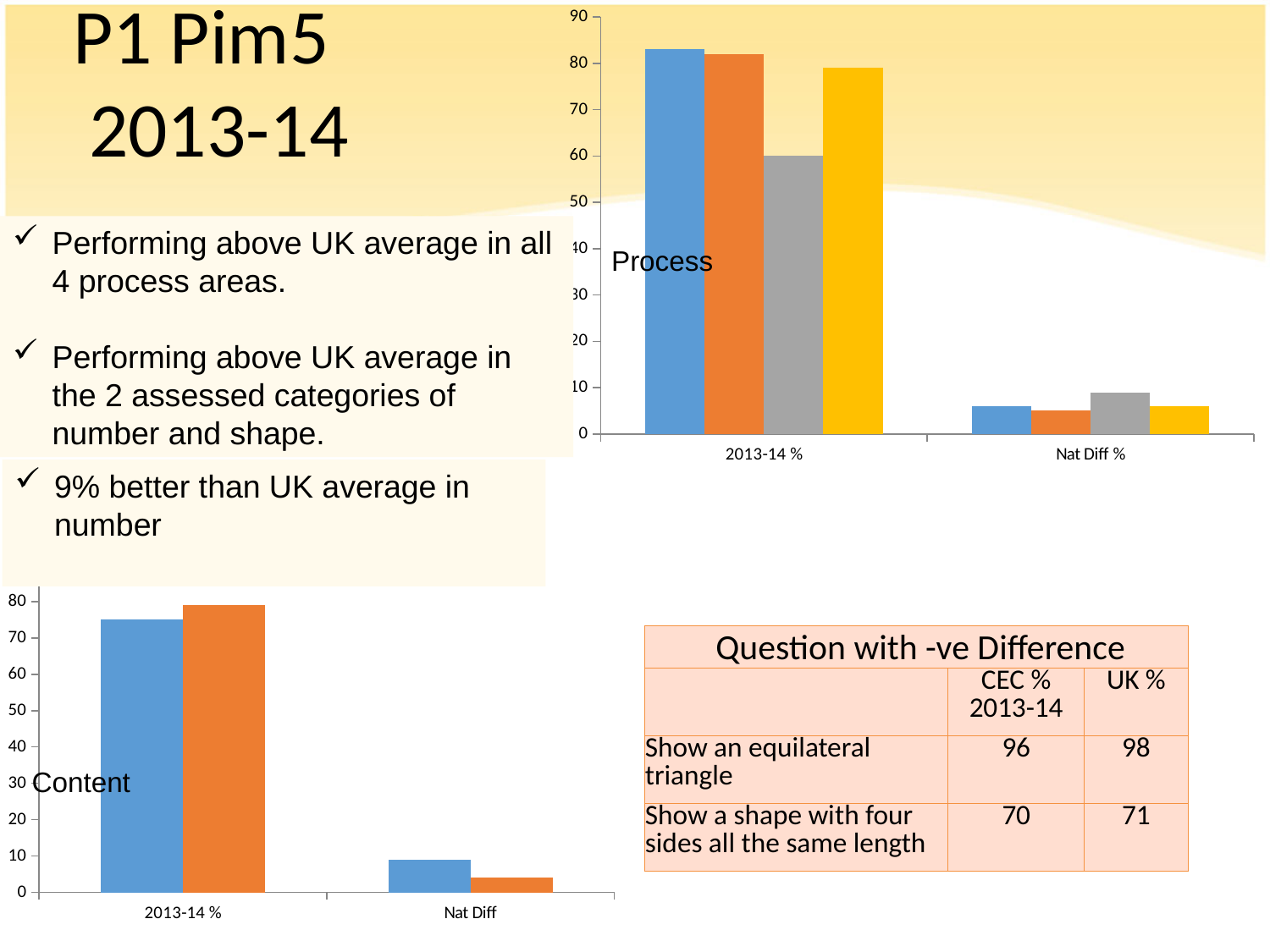
What kind of chart is the Process chart at the top right of the slide? bar chart In the Content chart, for Nat Diff, which is larger: the blue bar or the orange bar? the blue bar How many categories are shown on the x axis of the Content chart at the bottom left? 2 What are the two category labels on the x axis of the Content chart? 2013-14 % and Nat Diff In the Process chart, is the grey bar for 2013-14 % greater or less than 70? less In the Process chart, for 2013-14 %, which is larger: the grey bar or the yellow bar? the yellow bar How many bars are plotted for the 2013-14 % category in the Process chart? 4 In the Content chart, is the orange bar for 2013-14 % greater or less than 70? greater In the Process chart, which coloured bar is lowest for the 2013-14 % category? grey In the Process chart, is the blue bar for 2013-14 % greater or less than 80? greater How many categories are shown on the x axis of the Process chart? 2